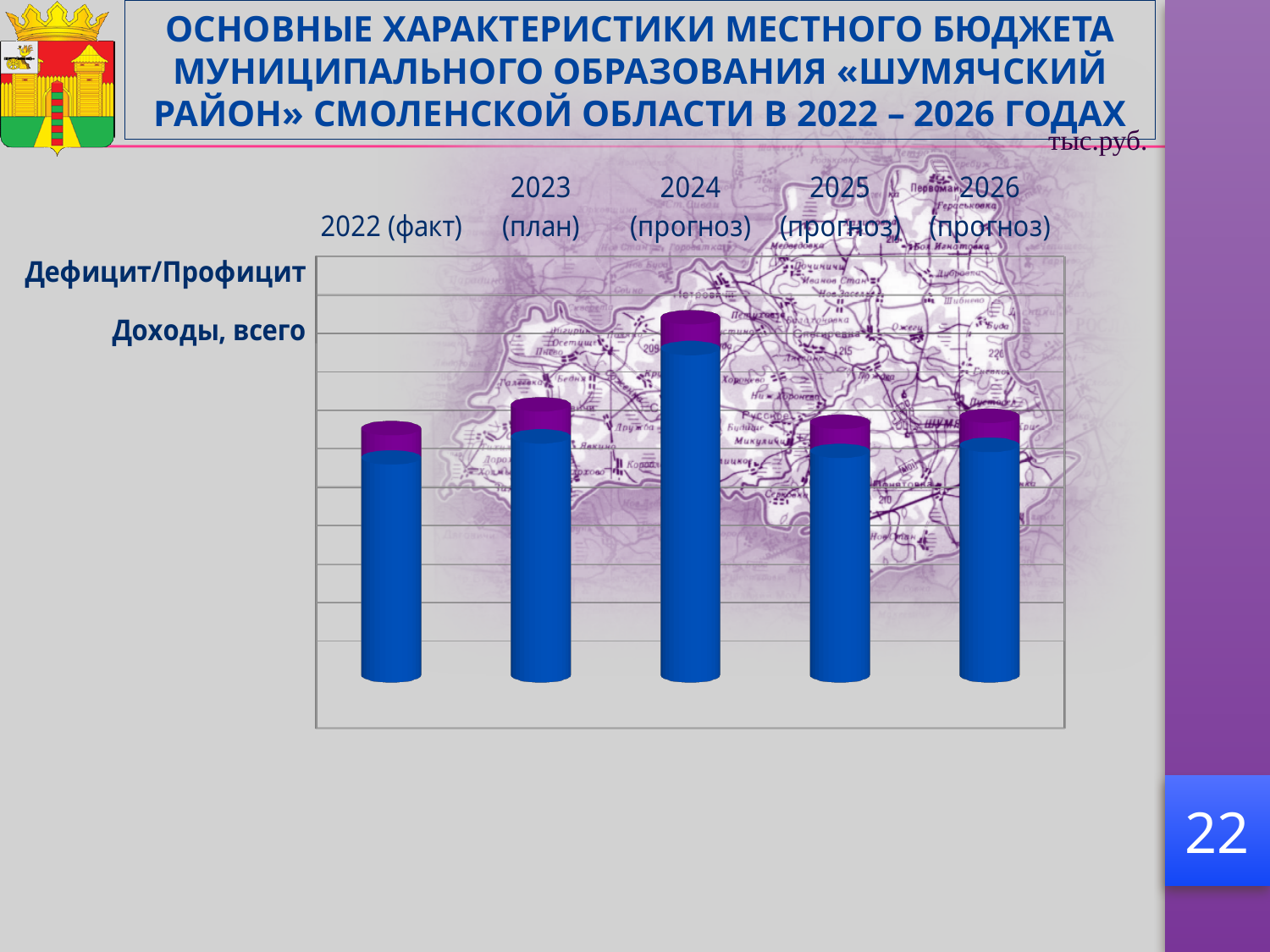
Which year has the tallest bar in the chart? 2024 (прогноз) What kind of chart is shown on the slide? bar chart How many year categories are plotted along the x axis of the chart? 5 Do the bar heights rise or fall from 2022 (факт) to 2024 (прогноз)? rise Which bar is taller, 2023 (план) or 2022 (факт)? 2023 (план) Which bar is taller, 2024 (прогноз) or 2023 (план)? 2024 (прогноз) What unit of measurement is indicated for the chart values? тыс.руб. Do the bar heights rise or fall from 2024 (прогноз) to 2025 (прогноз)? fall Which bar is taller, 2024 (прогноз) or 2025 (прогноз)? 2024 (прогноз)